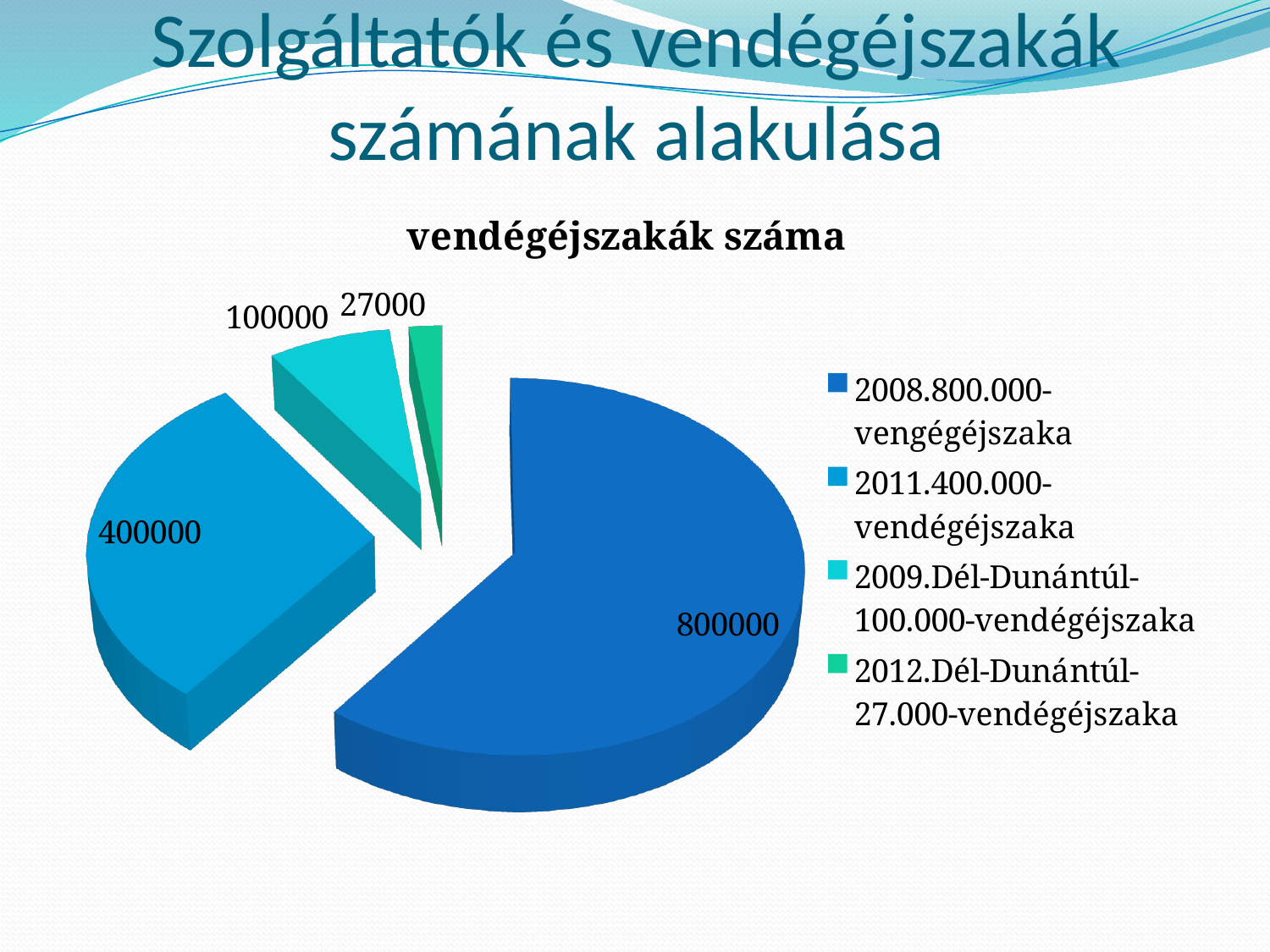
What value is shown for the 2008 slice? 800000 What type of chart is shown on the slide? Pie chart Which slice has the largest value? 2008 (800000) What value is shown for the 2011 slice? 400000 Which slice has the smallest value? 2012 Dél-Dunántúl (27000) What is the title of the chart? vendégéjszakák száma What is the difference between the 2008 value and the 2011 value? 400000 What value is shown for the 2009 Dél-Dunántúl slice? 100000 What value is shown for the 2012 Dél-Dunántúl slice? 27000 How many slices does the pie chart have? 4 Which is larger, the 2009 Dél-Dunántúl value or the 2012 Dél-Dunántúl value? 2009 Dél-Dunántúl What is the total of all four slice values? 1327000